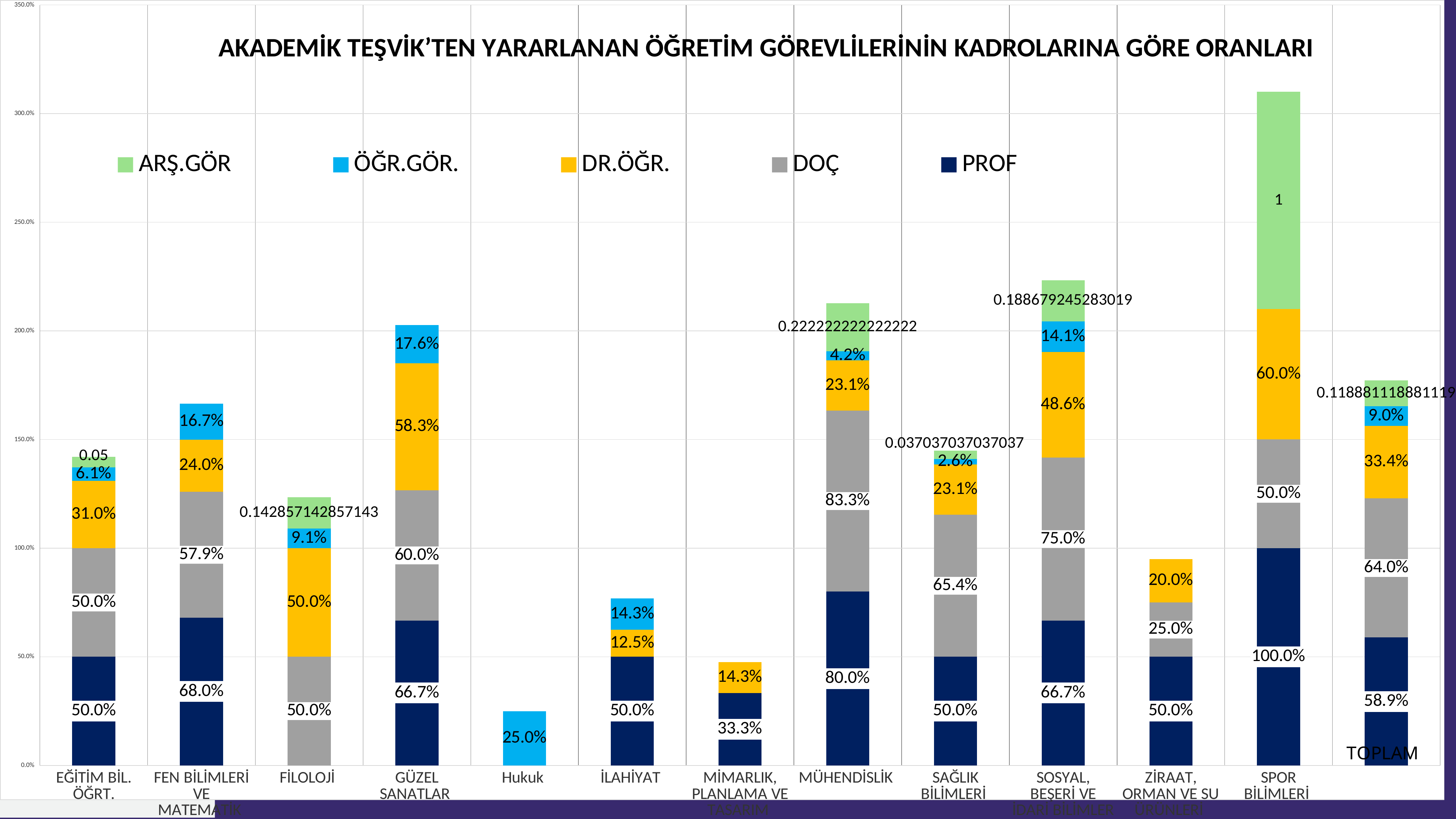
Which colour represents ARŞ.GÖR in the legend? Green What is the ÖĞR.GÖR. value for Hukuk? 25.0% Which has the larger DOÇ value: SOSYAL, BEŞERİ VE İDARİ BİLİMLER or GÜZEL SANATLAR? SOSYAL, BEŞERİ VE İDARİ BİLİMLER What kind of chart is shown on the slide? Stacked bar chart What is the DR.ÖĞR. value for GÜZEL SANATLAR? 58.3% What is the PROF value for MÜHENDİSLİK? 80.0% What is the DR.ÖĞR. value for TOPLAM? 33.4% Which category has the highest PROF value? SPOR BİLİMLERİ How many categories are shown along the x axis? 13 What is the difference between the DOÇ value for MÜHENDİSLİK and the DOÇ value for SAĞLIK BİLİMLERİ? 17.9 percentage points Is the total height of the stacked bar for MÜHENDİSLİK greater or less than 200.0%? greater How many series does the legend list? 5